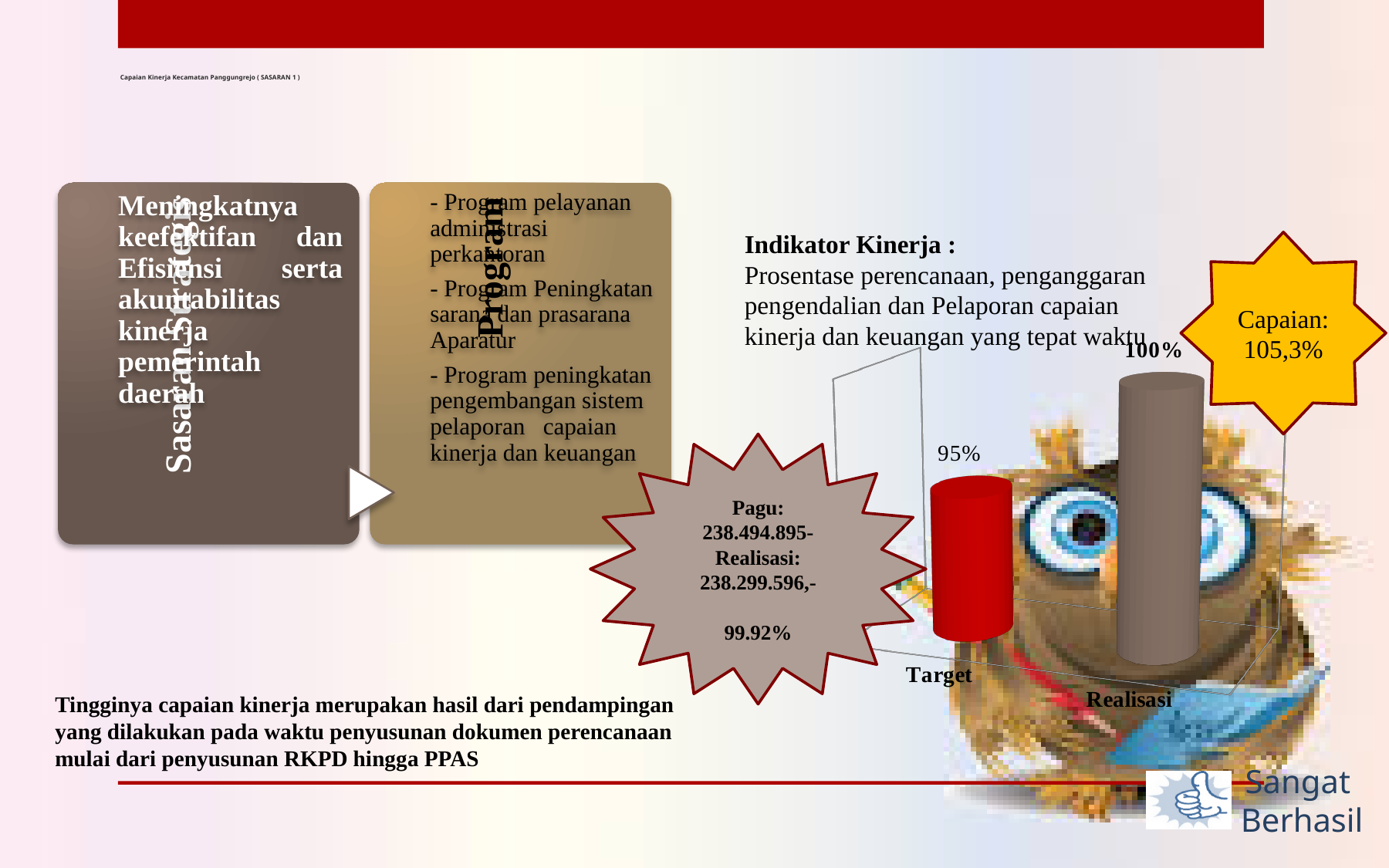
Do the values rise or fall from Target to Realisasi in the chart? Rise What is the difference between the Realisasi value and the Target value in the chart? 5% What colour is the Realisasi bar in the chart? Brown What is the value for Realisasi in the chart? 100% Which category has the higher value in the chart, Target or Realisasi? Realisasi How many categories are plotted in the chart? 2 What colour is the Target bar in the chart? Red Which category has the highest value in the chart? Realisasi Which category has the lowest value in the chart? Target What is the value for Target in the chart? 95% What kind of chart is shown on the slide? Bar chart